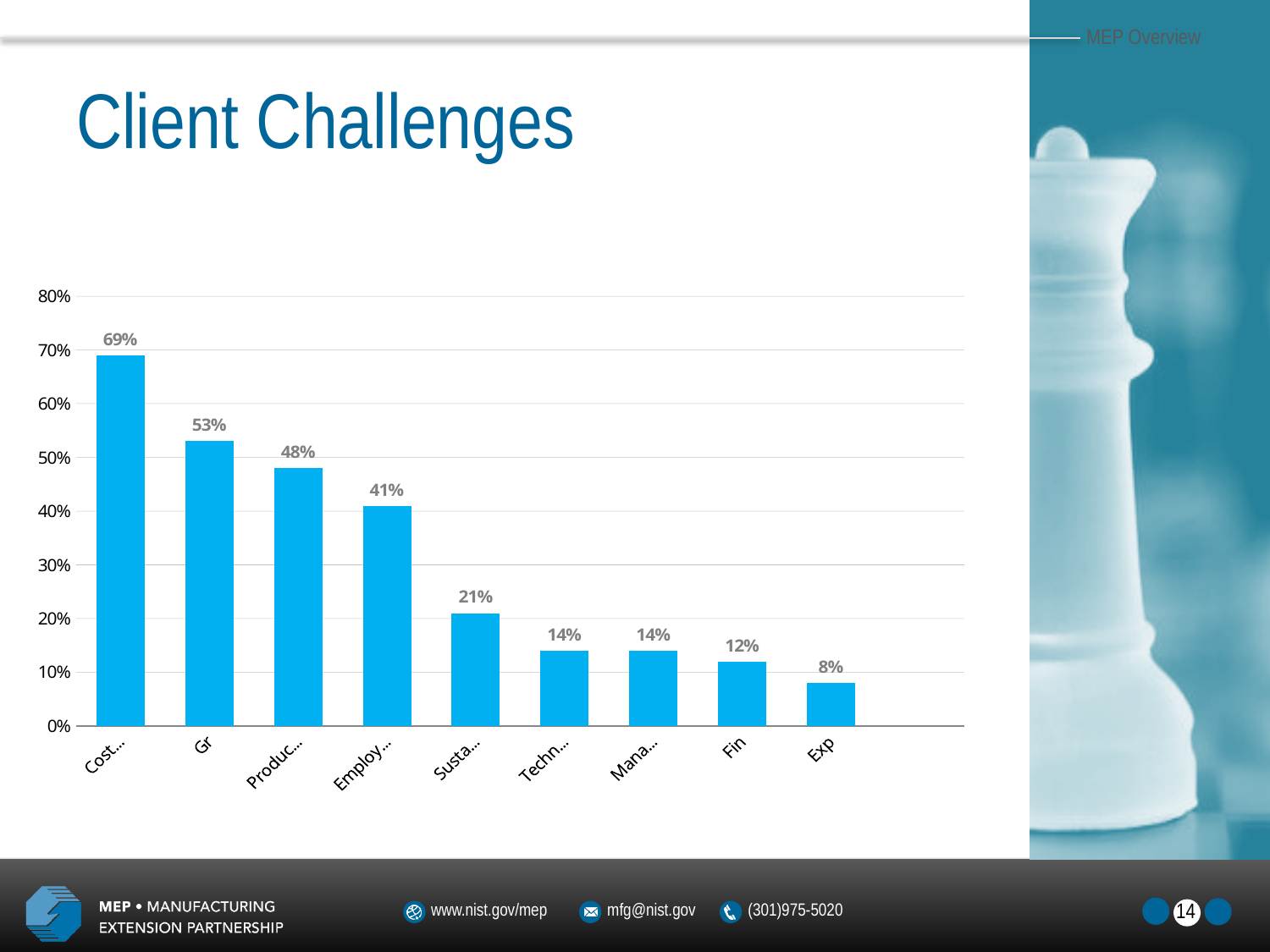
What is the value of the first bar, labelled "Cost..."? 69% What is the title of the slide containing the chart? Client Challenges Do the values rise or fall from left to right along the x axis? fall What is the value of the bar labelled "Gr"? 53% Which category has the lowest value? Exp What is the difference between the values for "Cost..." and "Gr"? 16% How many bars are plotted in the chart? 9 What type of chart is shown on the slide? bar chart What is the value of the last bar, labelled "Exp"? 8% What is the value of the bar labelled "Employ..."? 41% Which is larger, the value for "Produc..." or the value for "Susta..."? Produc... Which category has the highest value? Cost...